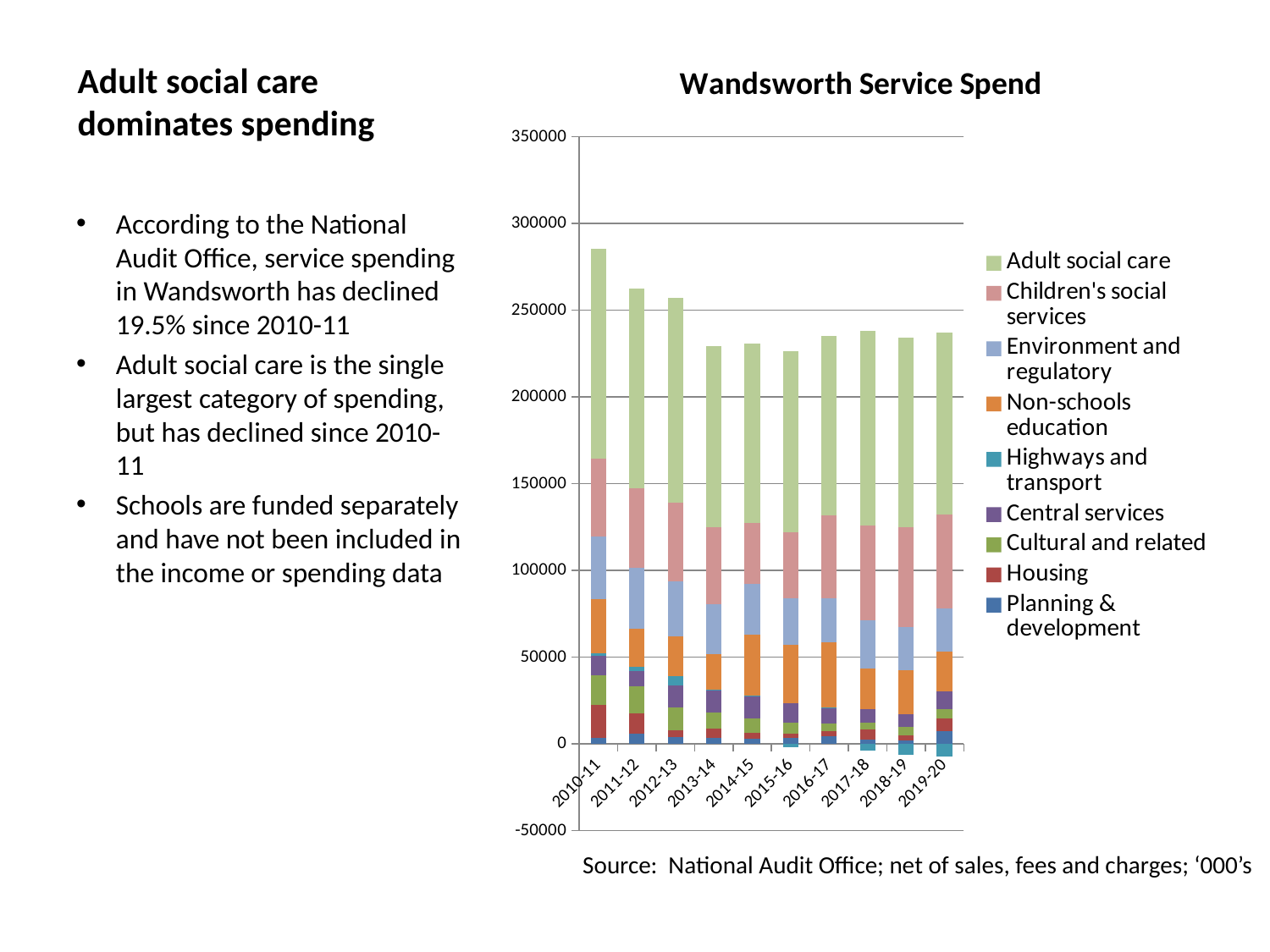
Which year has the larger total service spend, 2011-12 or 2015-16? 2011-12 Is the total service spend for 2011-12 greater or less than 250000? greater What kind of chart is shown on the slide? Stacked bar chart What is the title of the chart? Wandsworth Service Spend Does the total service spend generally rise or fall from 2010-11 to 2019-20? Fall How many series does the chart's legend list? 9 Which year has the highest total service spend in the chart? 2010-11 Which series is listed first in the chart's legend? Adult social care Is the total service spend for 2010-11 greater or less than 250000? greater Is the total service spend for 2013-14 greater or less than 250000? less How many years are shown along the x axis of the chart? 10 Which year has the larger total service spend, 2010-11 or 2019-20? 2010-11